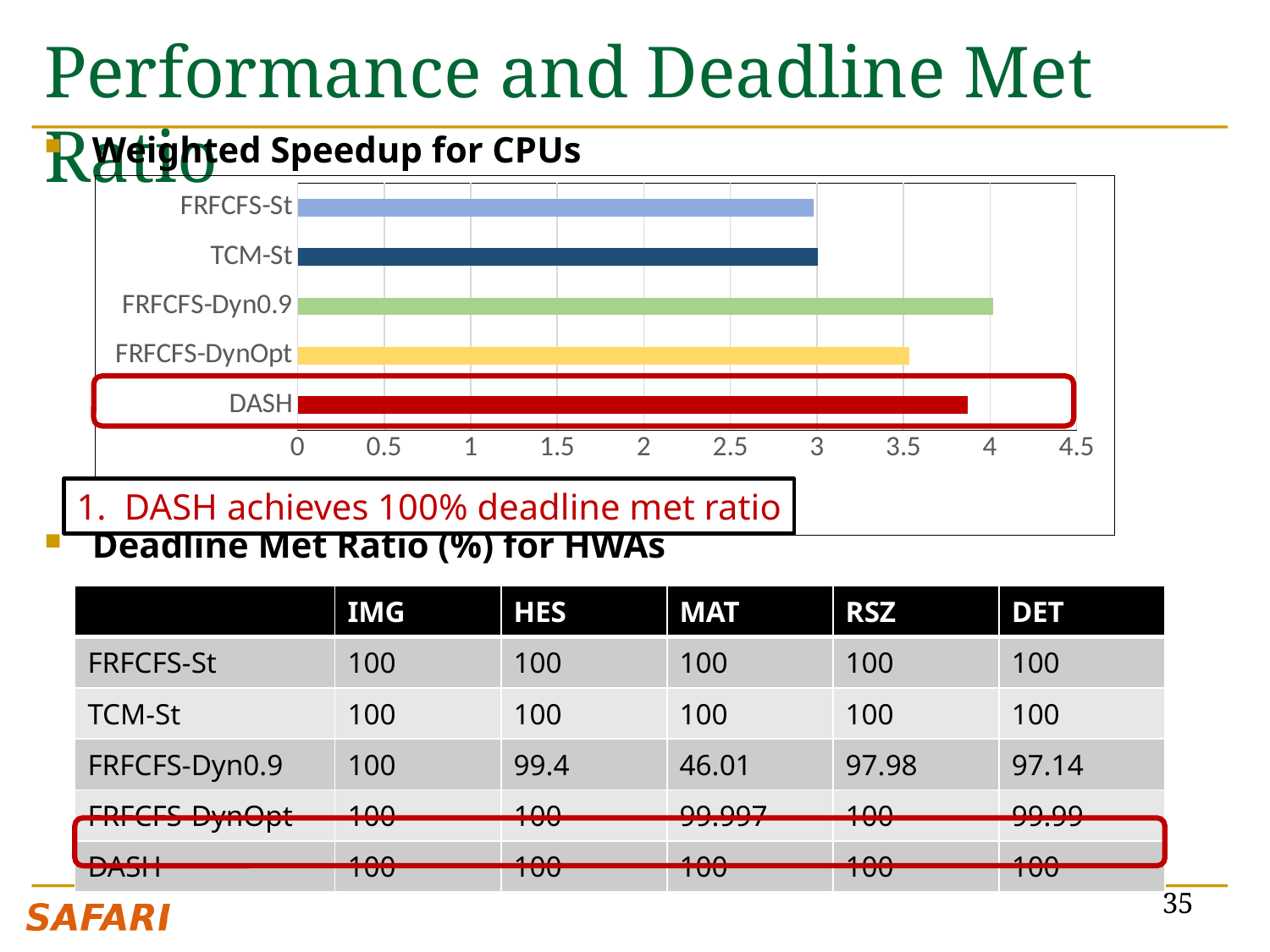
How many categories (scheduling policies) are plotted in the Weighted Speedup for CPUs chart? 5 In the Weighted Speedup for CPUs chart, which has the larger weighted speedup, DASH or FRFCFS-DynOpt? DASH In the Weighted Speedup for CPUs chart, is the value for FRFCFS-St greater or less than 3.5? less In the Weighted Speedup for CPUs chart, is the value for FRFCFS-DynOpt greater or less than 3? greater In the Weighted Speedup for CPUs chart, which has the larger weighted speedup, FRFCFS-Dyn0.9 or DASH? FRFCFS-Dyn0.9 What kind of chart is shown under the heading "Weighted Speedup for CPUs"? bar chart What is the title of the bar chart on the slide? Weighted Speedup for CPUs In the Weighted Speedup for CPUs chart, which category's bar is drawn in red and outlined with a red box? DASH In the Weighted Speedup for CPUs chart, is the value for FRFCFS-Dyn0.9 greater or less than 3.5? greater In the Weighted Speedup for CPUs chart, which category has the highest weighted speedup? FRFCFS-Dyn0.9